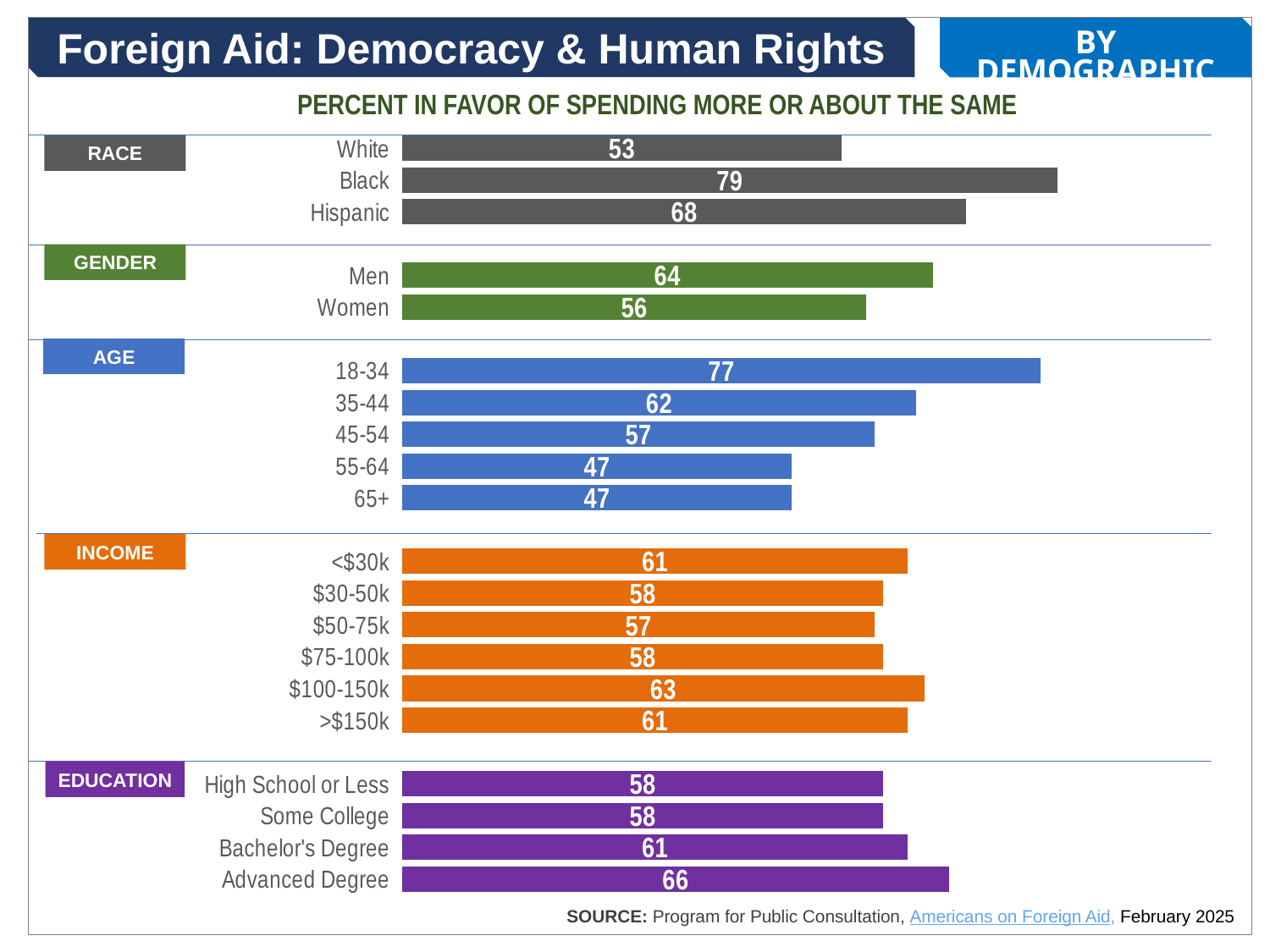
In the EDUCATION chart, is the value for Advanced Degree larger or smaller than the value for Bachelor's Degree? larger In the GENDER chart, what is the difference between the values for Men and Women? 8 In the RACE chart, which group has the lowest value? White In the AGE chart, which age group has the highest value? 18-34 In the AGE chart, what is the value for the 55-64 group? 47 What kind of chart is used on this slide? bar chart In the EDUCATION chart, what is the difference between the values for Advanced Degree and High School or Less? 8 In the AGE chart, how many age groups are shown? 5 In the RACE chart, what percent of Black respondents favor spending more or about the same? 79 What colour are the bars in the INCOME chart? orange In the INCOME chart, what is the value for the $50-75k group? 57 In the INCOME chart, which income group has the highest value? $100-150k